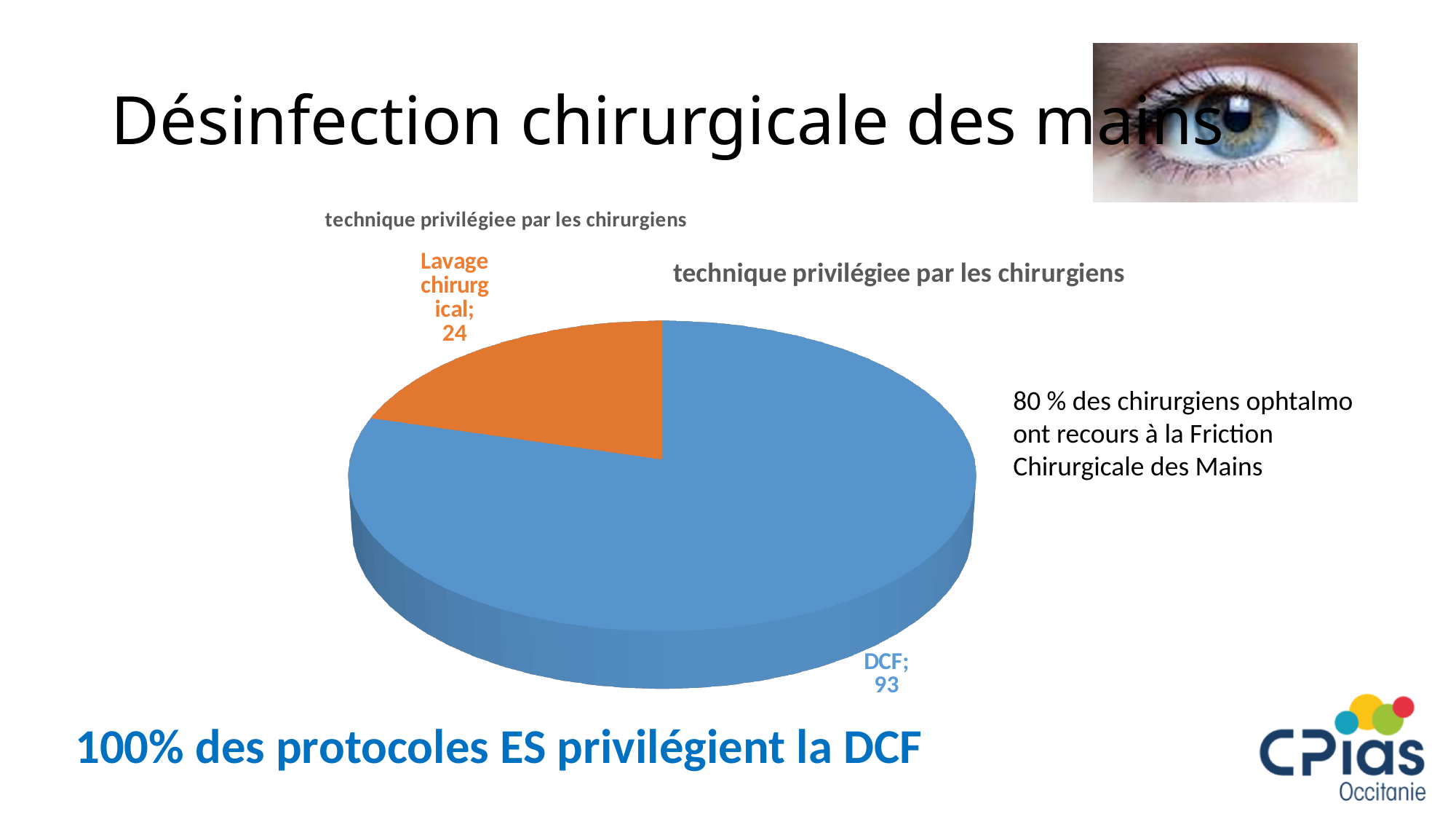
Which category has the smallest slice in the pie chart? Lavage chirurgical Which is larger, the value for DCF or the value for Lavage chirurgical? DCF What is the title of the pie chart? technique privilégiee par les chirurgiens What share of the pie does the DCF slice represent, to one decimal place? 79.5% What is the difference between the DCF value and the Lavage chirurgical value? 69 What colour is the DCF slice in the pie chart? blue How many slices does the pie chart have? 2 What is the value for Lavage chirurgical in the pie chart? 24 What is the value for DCF in the pie chart? 93 What is the total of the two values shown in the pie chart? 117 Which category has the largest slice in the pie chart? DCF What type of chart is shown on the slide? pie chart